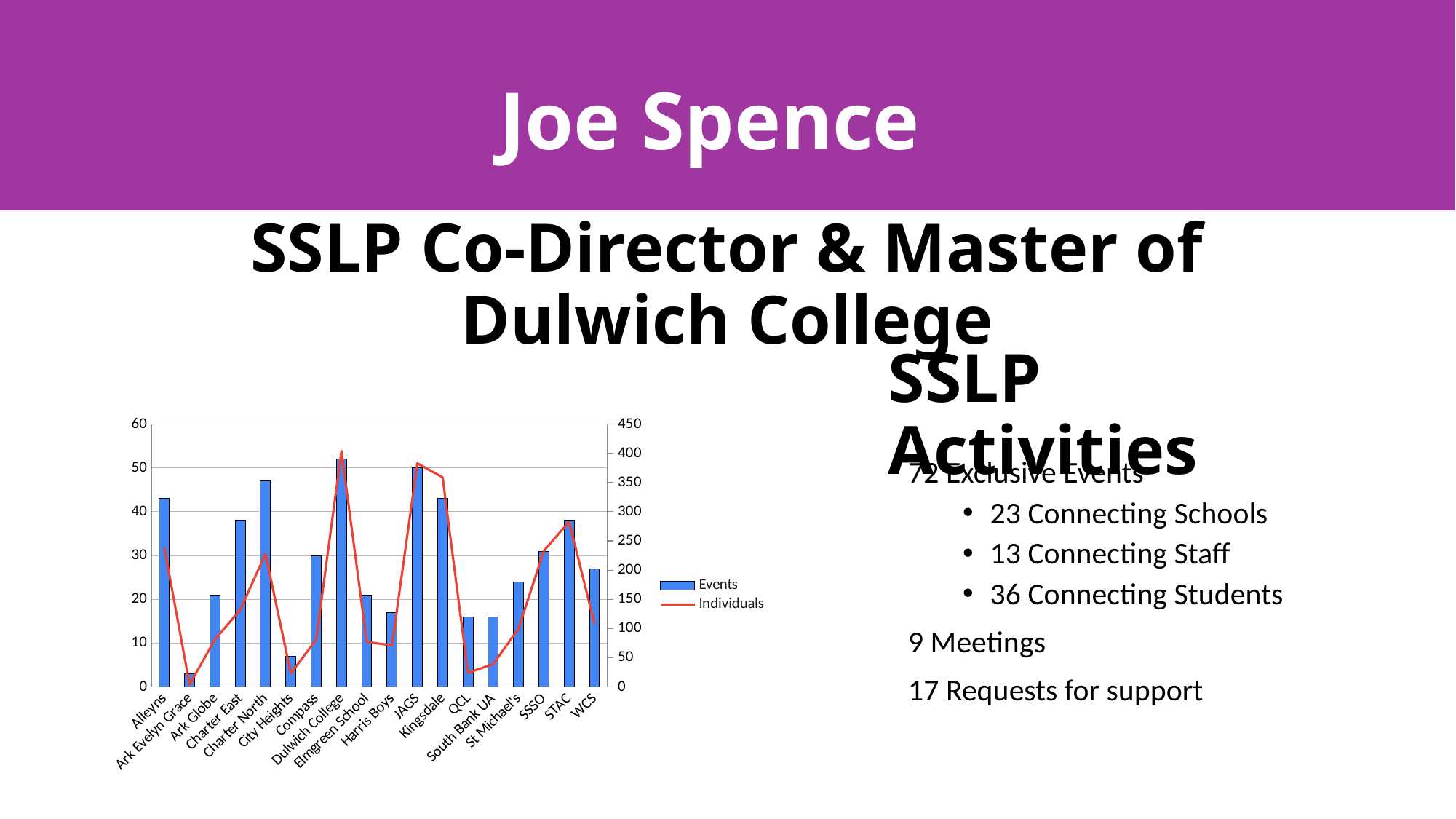
Which series in the chart is drawn as a line rather than bars? Individuals What are the two series named in the chart legend? Events and Individuals How many series does the chart legend list? 2 Is the Events value for Kingsdale greater or less than 40? greater Is the Events value for Alleyns greater or less than 40? greater Which has the larger Events bar, Charter North or Charter East? Charter North Is the Individuals value for Dulwich College greater or less than 350? greater How many schools or organisations are shown along the x axis of the chart? 18 Which category has the lowest Events bar in the chart? Ark Evelyn Grace Which has the larger Events bar, Alleyns or Ark Globe? Alleyns